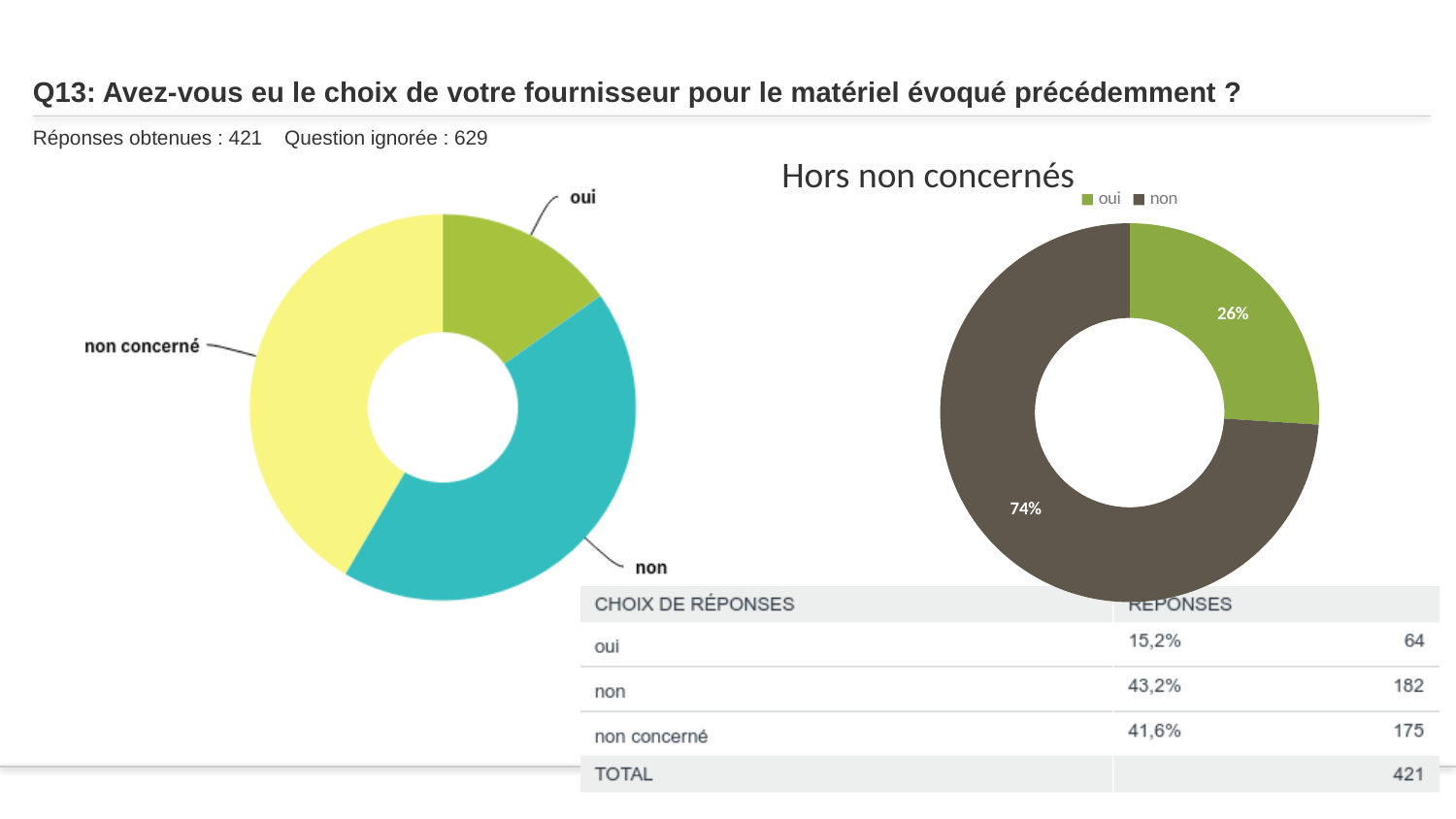
What kind of chart is the chart titled 'Hors non concernés'? Pie chart (donut) In the chart titled 'Hors non concernés', what share is shown for 'oui'? 26% How many slices does the left-hand pie chart have? 3 In the left-hand pie chart, which category has the smallest slice? oui According to the table on the slide, how many responses were 'non'? 182 According to the table on the slide, what percentage of responses is 'non concerné'? 41,6% How many entries does the legend of the chart titled 'Hors non concernés' list? 2 In the left-hand pie chart, is the slice for 'non' larger or smaller than the slice for 'oui'? larger In the chart titled 'Hors non concernés', what is the difference in percentage points between 'non' and 'oui'? 48 percentage points In the chart titled 'Hors non concernés', which category has the largest slice? non In the chart titled 'Hors non concernés', what share is shown for 'non'? 74% What colour is the 'non concerné' slice in the left-hand pie chart? Yellow